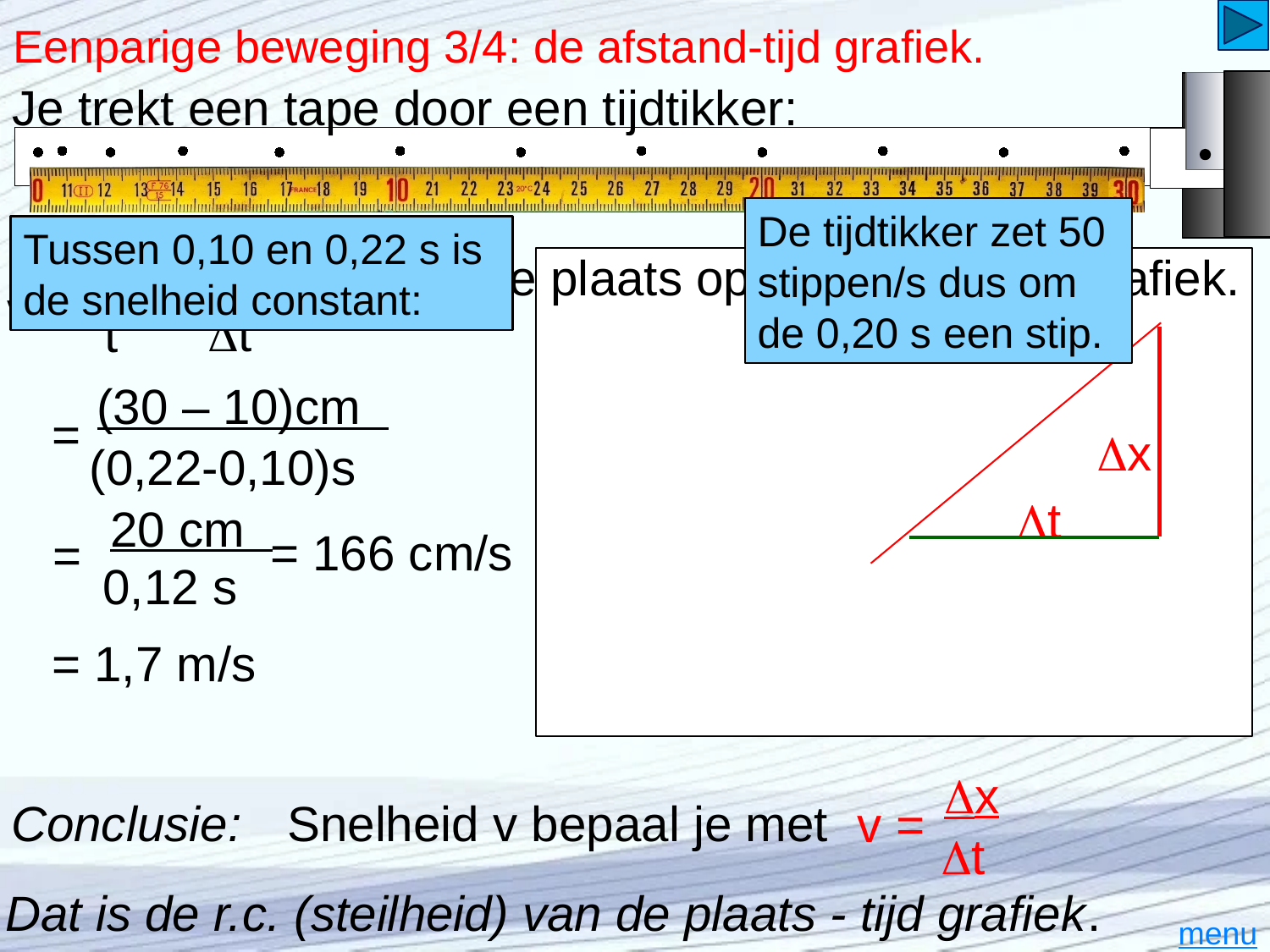
In the sketched graph on the right, which two labels are written on the slope triangle? Δx and Δt What kind of chart is sketched in the white box on the right of the slide? line chart In the sketched graph on the right, does the red line rise or fall from left to right? rises